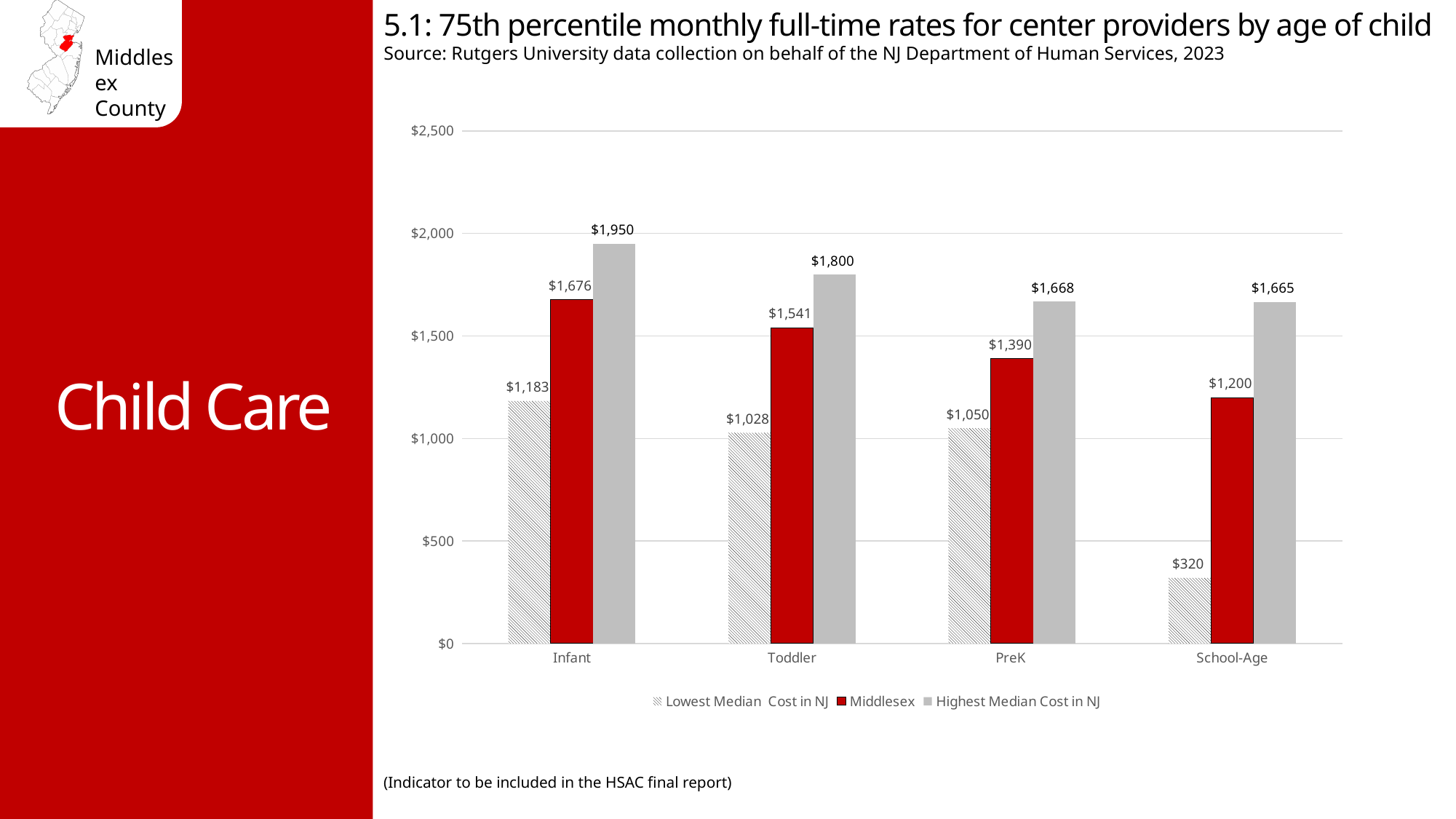
How many age categories are shown on the x axis? 4 How many series does the legend list? 3 Is the Middlesex value for School-Age greater or less than $1,500? less What is the Middlesex value for Infant? $1,676 What is the difference between the Highest Median Cost in NJ and the Middlesex value for PreK? $278 What is the Highest Median Cost in NJ for Toddler? $1,800 Which age category has the lowest Lowest Median Cost in NJ value? School-Age What is the Lowest Median Cost in NJ for School-Age? $320 Which is larger: the Middlesex value for Toddler or the Middlesex value for PreK? Toddler What kind of chart is shown on the slide? bar chart Do the Middlesex values rise or fall from Infant to School-Age? fall Which age category has the highest Middlesex value? Infant